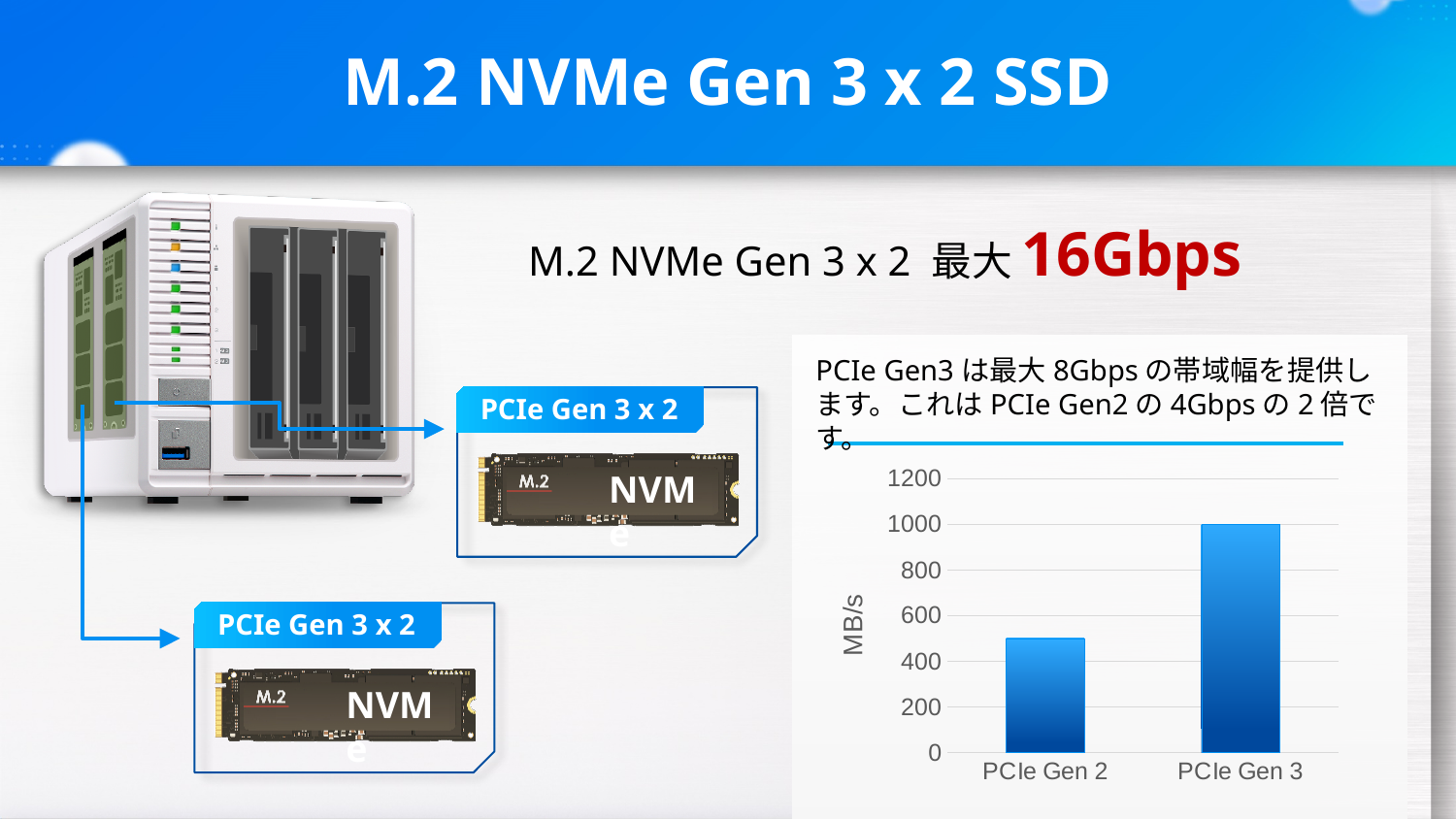
Do the values rise or fall from PCIe Gen 2 to PCIe Gen 3 along the x axis? rise Is the value for PCIe Gen 3 greater or less than 800? greater Is the value for PCIe Gen 2 greater or less than 600? less Which is larger on the bar chart, PCIe Gen 2 or PCIe Gen 3? PCIe Gen 3 What is the highest tick value shown on the vertical axis of the bar chart? 1200 Which category has the highest value on the bar chart? PCIe Gen 3 What value does the PCIe Gen 3 bar reach on the MB/s axis? 1000 Which category has the lowest value on the bar chart? PCIe Gen 2 Is the value for PCIe Gen 2 greater or less than 400? greater What kind of chart is shown on the slide? bar chart What is the label on the vertical axis of the bar chart? MB/s How many categories are plotted on the bar chart? 2